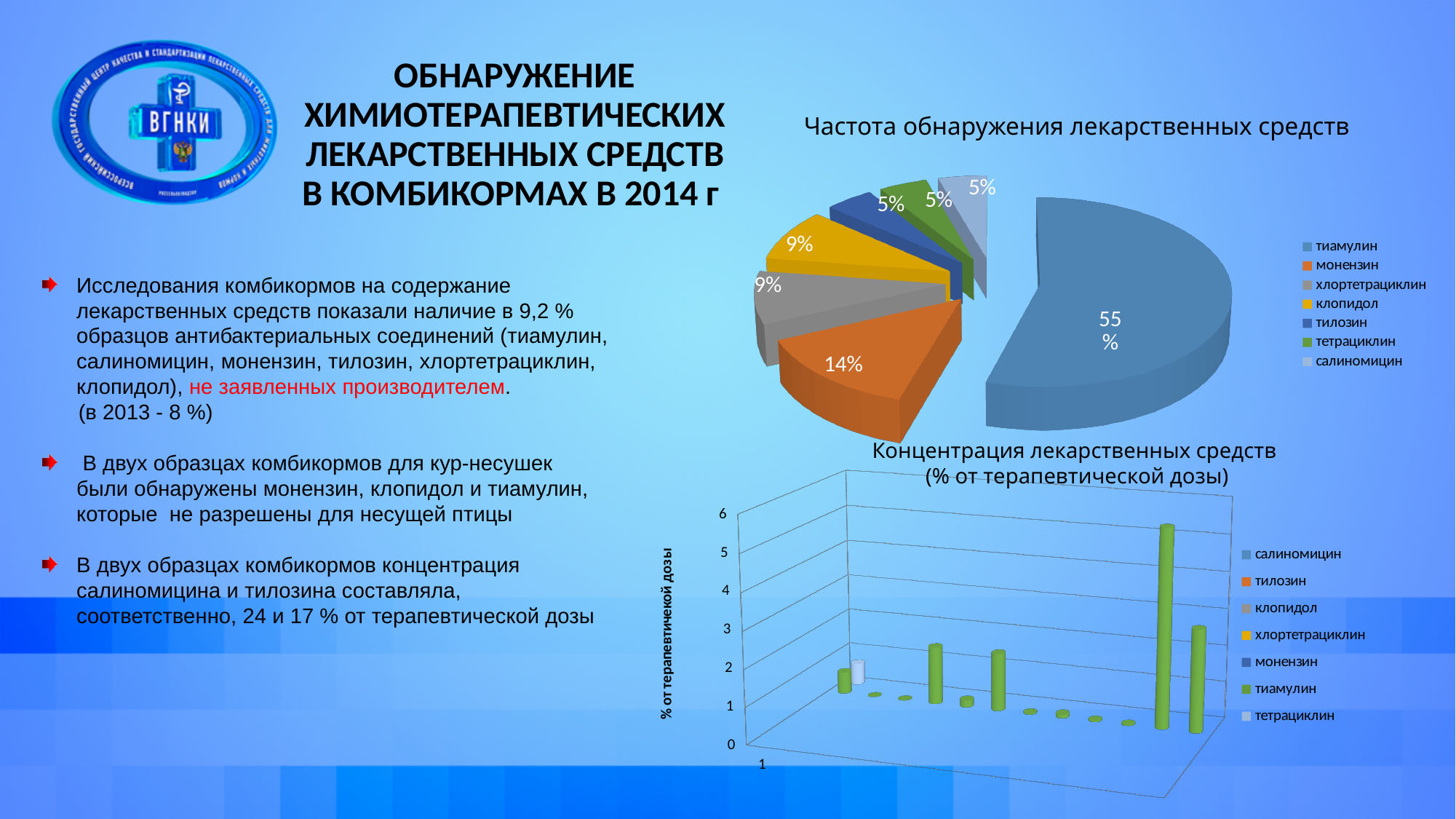
In the pie chart 'Частота обнаружения лекарственных средств', what is the difference between the shares of тиамулин and монензин? 41% How many entries does the legend of the pie chart 'Частота обнаружения лекарственных средств' list? 7 In the pie chart 'Частота обнаружения лекарственных средств', which is larger, the share of монензин or the share of хлортетрациклин? монензин In the pie chart 'Частота обнаружения лекарственных средств', which drug has the largest share? тиамулин What is the vertical axis title of the lower chart 'Концентрация лекарственных средств'? % от терапевтической дозы In the pie chart 'Частота обнаружения лекарственных средств', what share does тиамулин have? 55% In the pie chart 'Частота обнаружения лекарственных средств', what share does клопидол have? 9% In the pie chart 'Частота обнаружения лекарственных средств', how many slices are labelled 5%? 3 How many series does the legend of the lower chart 'Концентрация лекарственных средств' list? 7 What kind of chart is the lower chart 'Концентрация лекарственных средств (% от терапевтической дозы)'? bar chart What kind of chart is the upper chart 'Частота обнаружения лекарственных средств'? pie chart In the pie chart 'Частота обнаружения лекарственных средств', what share does монензин have? 14%